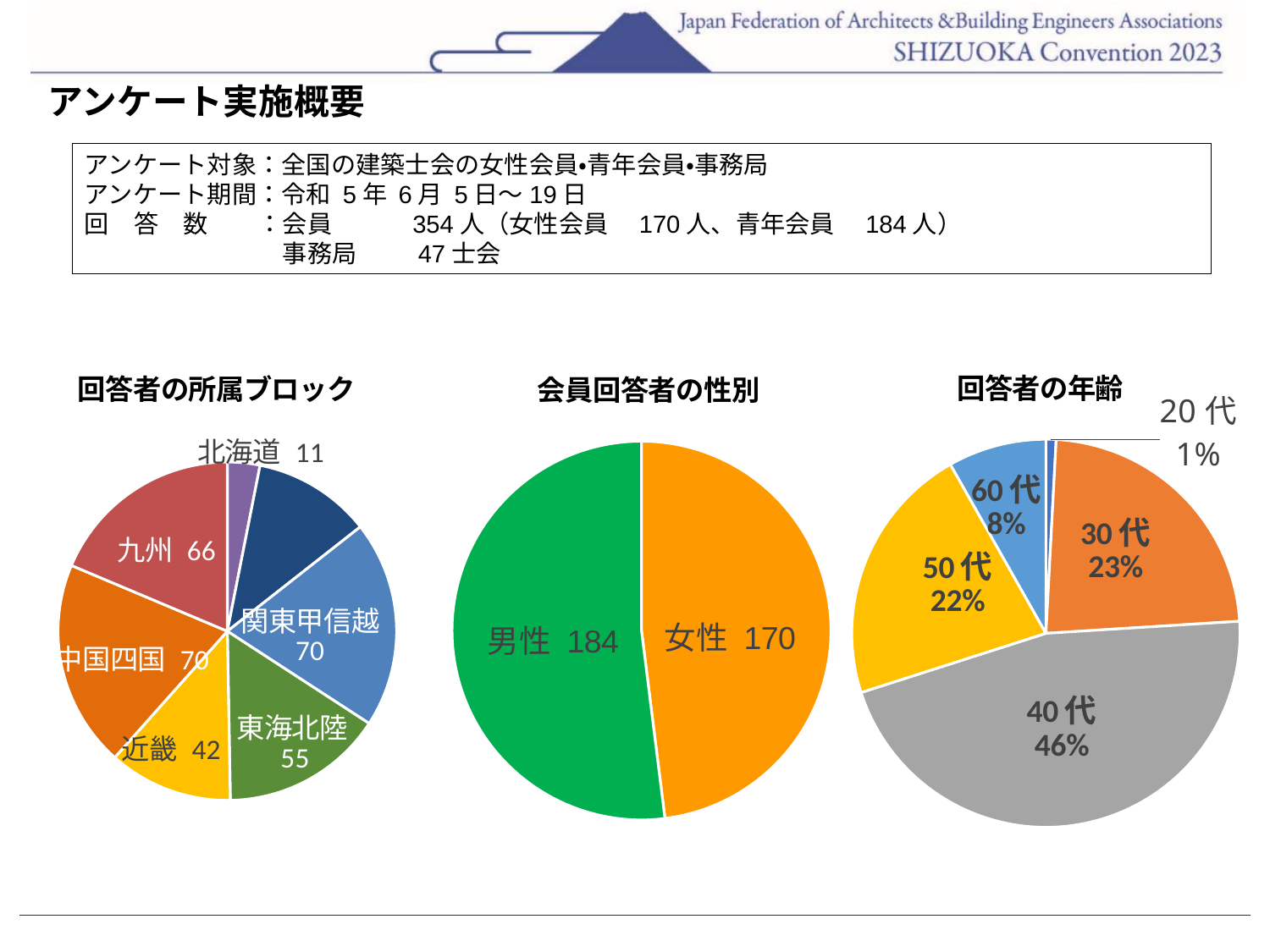
In the 回答者の所属ブロック pie chart, what is the value for 東海北陸? 55 In the 会員回答者の性別 pie chart, what is the value for 女性? 170 In the 回答者の所属ブロック pie chart, what is the value for 近畿? 42 What type of chart is the 会員回答者の性別 chart? pie chart In the 回答者の所属ブロック pie chart, which is larger, 九州 or 東海北陸? 九州 In the 会員回答者の性別 pie chart, what is the difference between 男性 and 女性? 14 In the 会員回答者の性別 pie chart, which group has the larger value? 男性 In the 回答者の所属ブロック pie chart, which labelled block has the smallest value? 北海道 In the 回答者の年齢 pie chart, which age group has the smallest share? 20代 How many age groups are shown in the 回答者の年齢 pie chart? 5 In the 回答者の年齢 pie chart, what share of respondents are 40代? 46% In the 回答者の所属ブロック pie chart, what is the value for 九州? 66